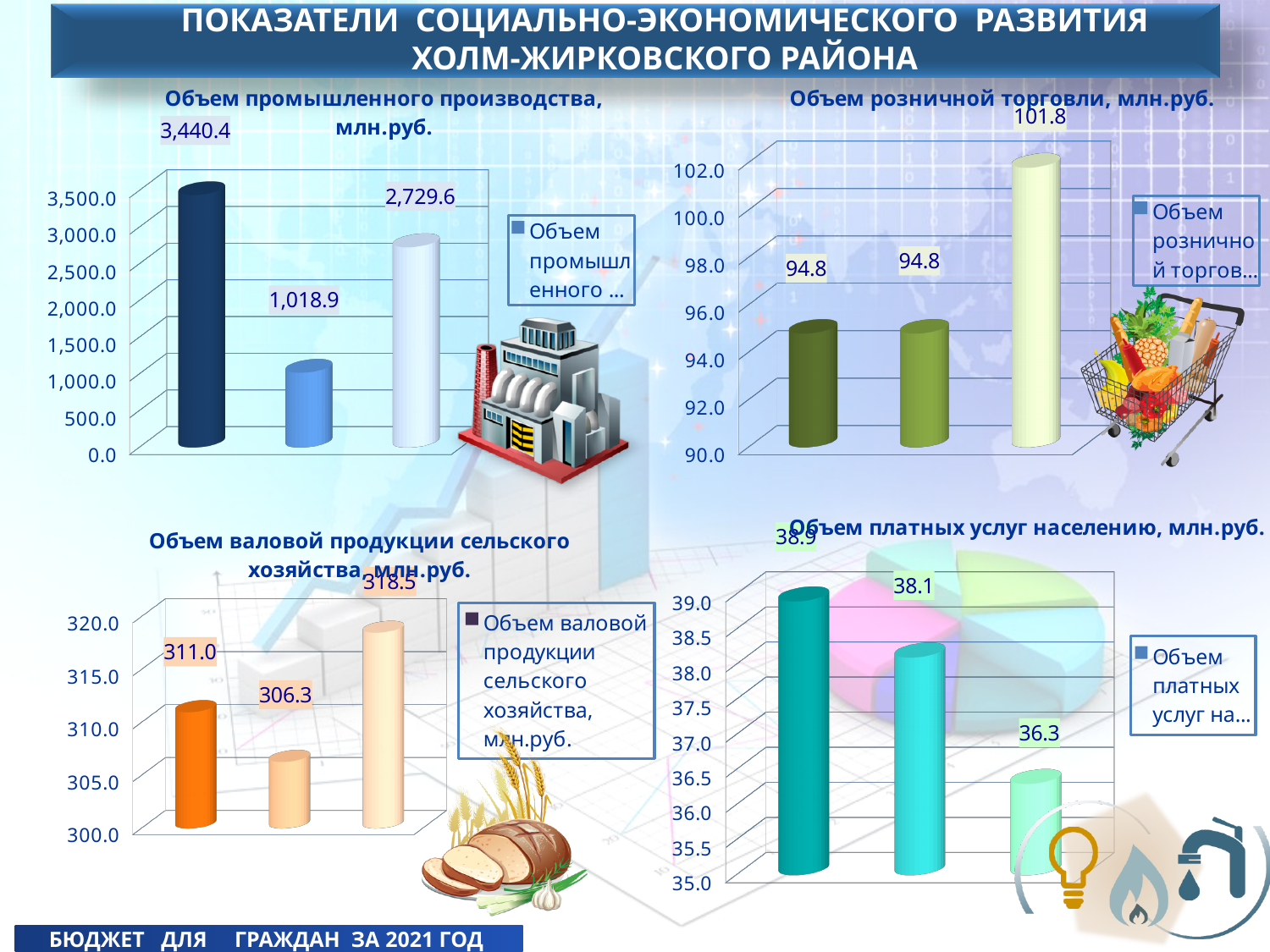
In the chart 'Объем валовой продукции сельского хозяйства, млн.руб.', what is the value of the second (middle) bar? 306.3 In the chart 'Объем платных услуг населению, млн.руб.', what is the difference between the first bar and the third bar? 2.6 In the chart 'Объем промышленного производства, млн.руб.', which bar has the lowest value? the second (middle) bar, 1,018.9 In the chart 'Объем промышленного производства, млн.руб.', what is the difference between the first bar and the third bar? 710.8 In the chart 'Объем розничной торговли, млн.руб.', is the value of the first bar greater or less than 96.0? less In the chart 'Объем платных услуг населению, млн.руб.', which is larger: the second bar or the third bar? the second bar (38.1) In the chart 'Объем платных услуг населению, млн.руб.', do the values rise or fall from left to right? fall In the chart 'Объем розничной торговли, млн.руб.', what is the value of the third (rightmost) bar? 101.8 In the chart 'Объем розничной торговли, млн.руб.', how many bars are plotted? 3 In the chart 'Объем промышленного производства, млн.руб.', what is the value of the first (leftmost) bar? 3,440.4 In the chart 'Объем валовой продукции сельского хозяйства, млн.руб.', which bar has the highest value? the third (rightmost) bar, 318.5 What type of chart is 'Объем валовой продукции сельского хозяйства, млн.руб.'? bar chart